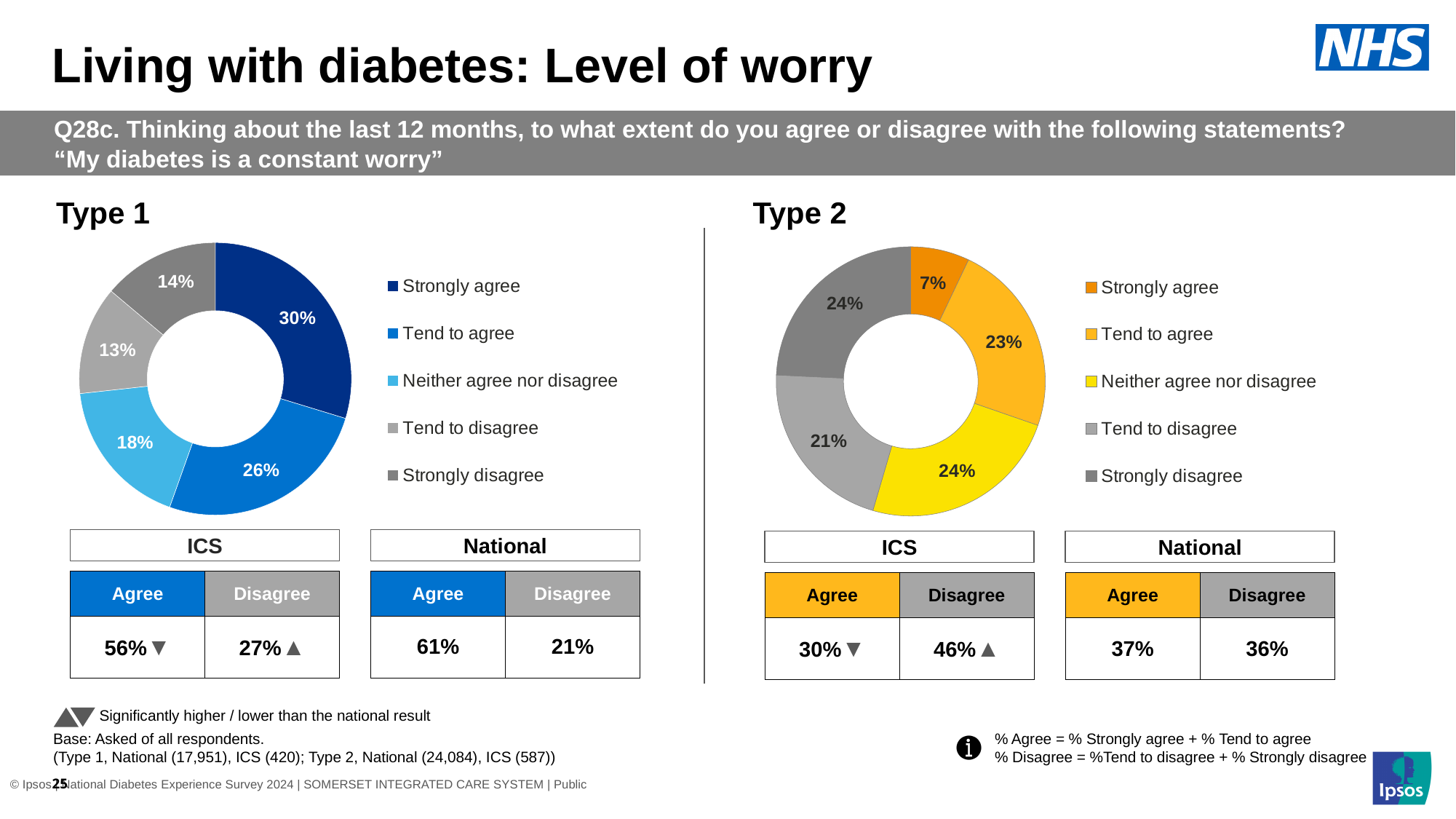
In the Type 1 chart, what percentage neither agree nor disagree? 18% What type of chart is used to show the Type 1 and Type 2 results? Doughnut (pie) chart In the Type 1 chart, what percentage of respondents strongly agree? 30% How many response categories does the legend of the Type 1 chart list? 5 In the Type 1 chart, which response category has the largest share? Strongly agree In the Type 2 chart, what is the difference between the Strongly disagree and Strongly agree shares? 17% In the Type 1 chart, which response category has the smallest share? Tend to disagree In the Type 1 chart, what is the difference between the Strongly agree and Tend to agree shares? 4% In the Type 2 chart, what percentage of respondents tend to agree? 23% Which is larger in the Type 2 chart: Tend to agree or Tend to disagree? Tend to agree In the Type 2 chart, which response category has the smallest share? Strongly agree In the Type 2 chart, what percentage tend to disagree? 21%